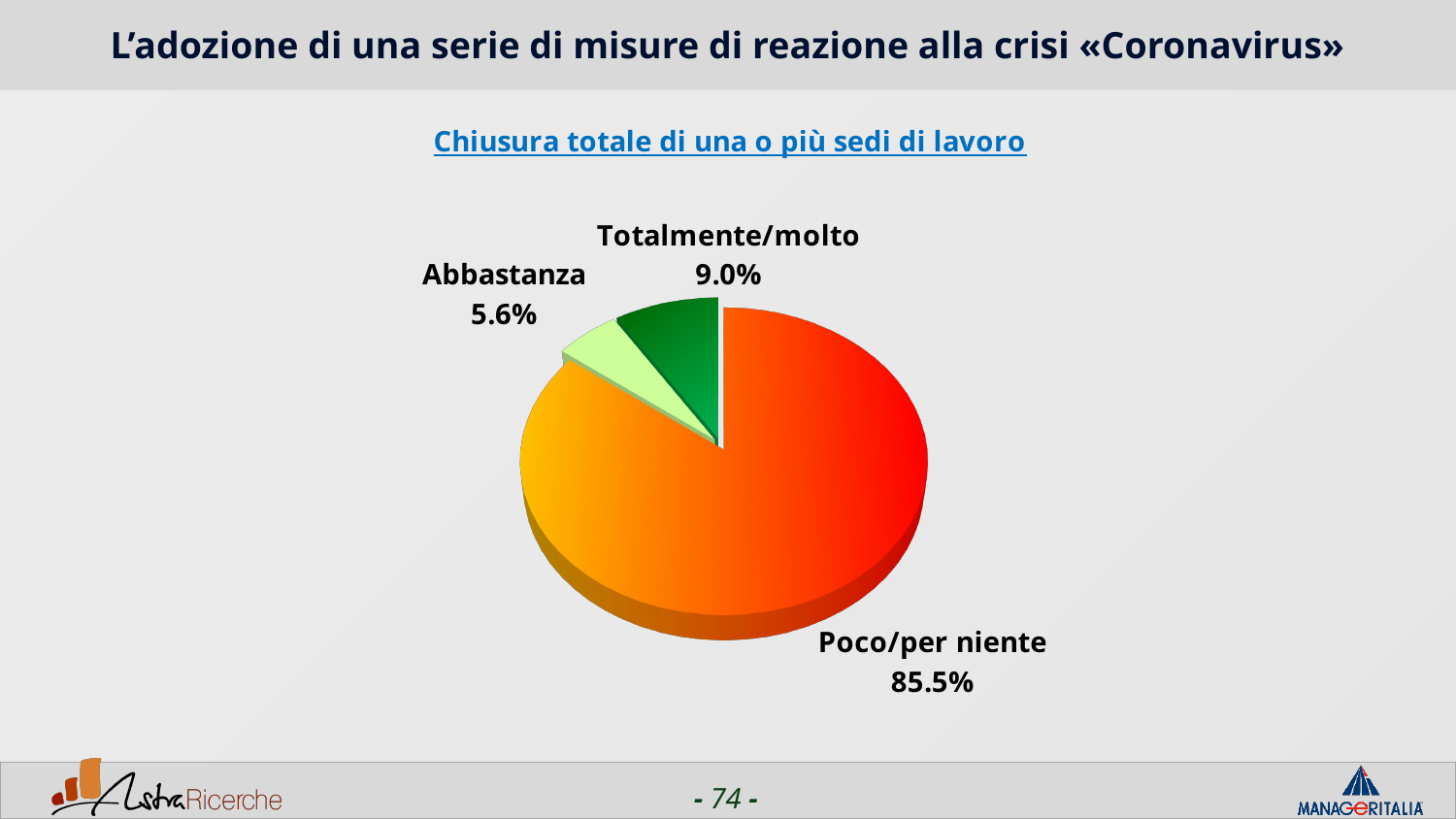
Which category has the largest slice? Poco/per niente What is the difference between the values for Poco/per niente and Totalmente/molto? 76.5% What is the difference between the values for Totalmente/molto and Abbastanza? 3.4% What colour is the Poco/per niente slice? red/orange Which category has the smallest slice? Abbastanza Which is larger, the value for Totalmente/molto or the value for Abbastanza? Totalmente/molto What is the title of the chart? Chiusura totale di una o più sedi di lavoro How many slices does the pie chart have? 3 What is the value for Totalmente/molto? 9.0% What is the value for Poco/per niente? 85.5% What is the value for Abbastanza? 5.6% What kind of chart is shown on the slide? pie chart